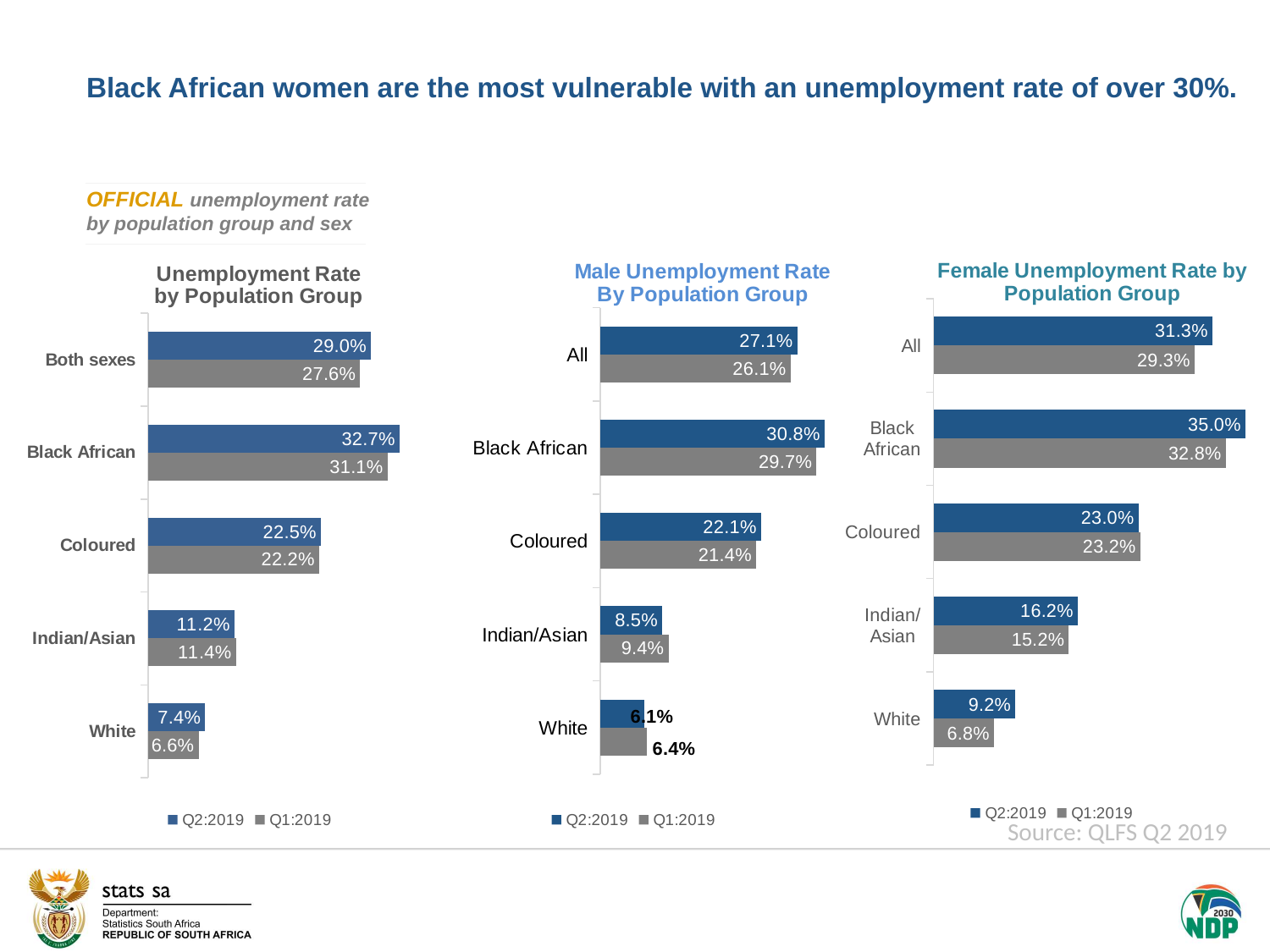
What type of chart is the 'Unemployment Rate by Population Group' chart? Bar chart How many series does the legend of the 'Female Unemployment Rate by Population Group' chart list? 2 What are the two series listed in the legend of the 'Unemployment Rate by Population Group' chart? Q2:2019 and Q1:2019 In the 'Female Unemployment Rate by Population Group' chart, which population group has the highest Q2:2019 unemployment rate? Black African In the 'Unemployment Rate by Population Group' chart, which is larger for Indian/Asian: the Q2:2019 value or the Q1:2019 value? Q1:2019 How many population group categories are shown in the 'Male Unemployment Rate By Population Group' chart? 5 In the 'Unemployment Rate by Population Group' chart, what is the Q2:2019 value for Black African? 32.7% In the 'Male Unemployment Rate By Population Group' chart, which population group has the lowest Q2:2019 unemployment rate? White In the 'Male Unemployment Rate By Population Group' chart, what is the difference between the Q2:2019 values for Black African and White? 24.7% In the 'Female Unemployment Rate by Population Group' chart, what is the Q2:2019 value for Indian/Asian? 16.2% In the 'Male Unemployment Rate By Population Group' chart, what is the Q1:2019 value for Coloured? 21.4% In the 'Female Unemployment Rate by Population Group' chart, what is the difference between the Q2:2019 and Q1:2019 values for White? 2.4%